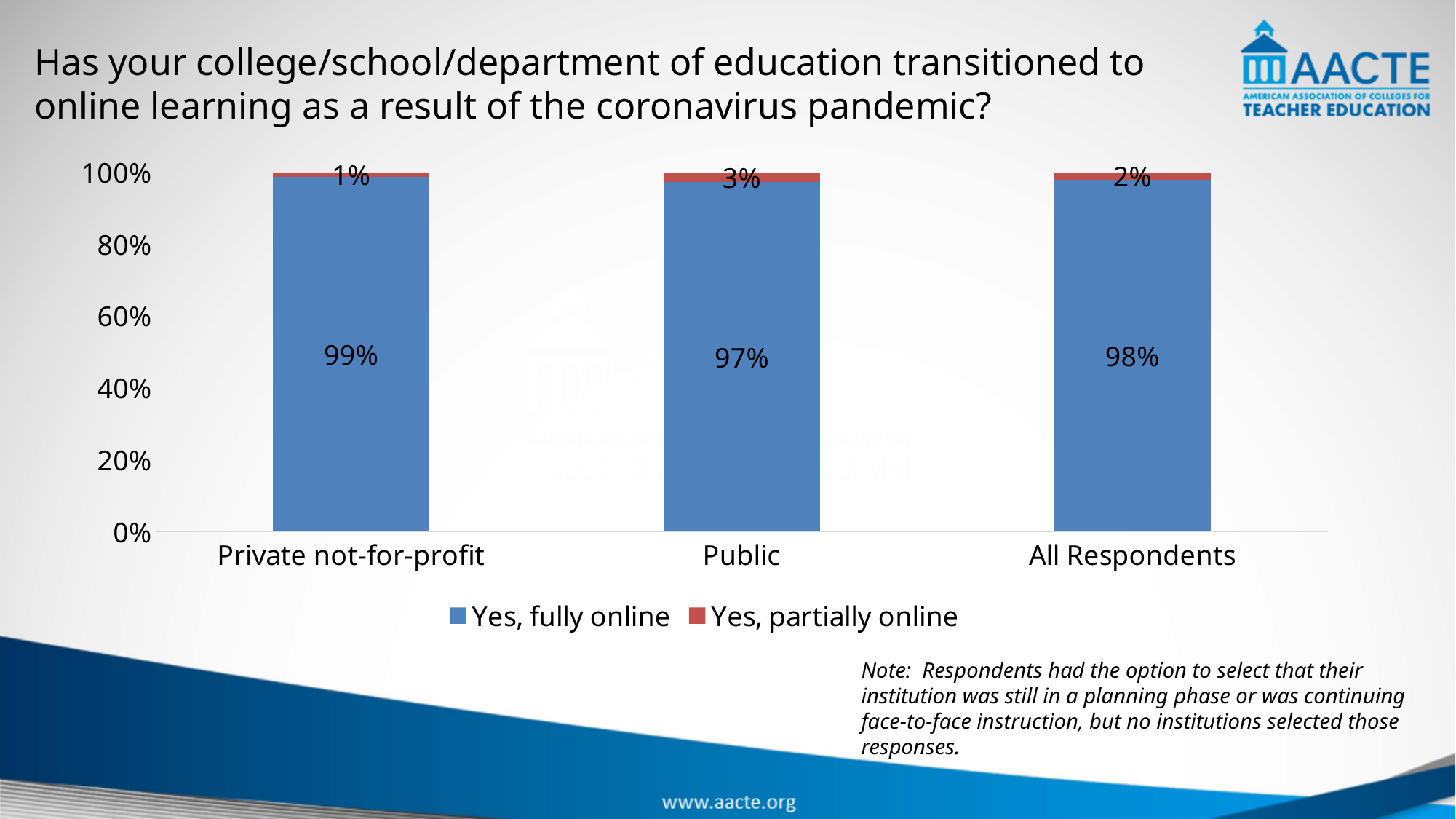
What kind of chart is shown on the slide? Stacked bar chart What is the "Yes, fully online" value for All Respondents? 98% How many categories are shown on the x axis? 3 What percentage of Private not-for-profit respondents answered "Yes, fully online"? 99% How many series does the legend list? 2 Which category has the highest "Yes, fully online" percentage? Private not-for-profit What is the difference between the "Yes, fully online" values for Private not-for-profit and Public? 2% What is the "Yes, partially online" value for Private not-for-profit? 1% What percentage of Public respondents answered "Yes, partially online"? 3% Which is larger: the "Yes, partially online" value for Public or for All Respondents? Public Which category has the lowest "Yes, fully online" percentage? Public What is the total of the stacked bar for Public? 100%